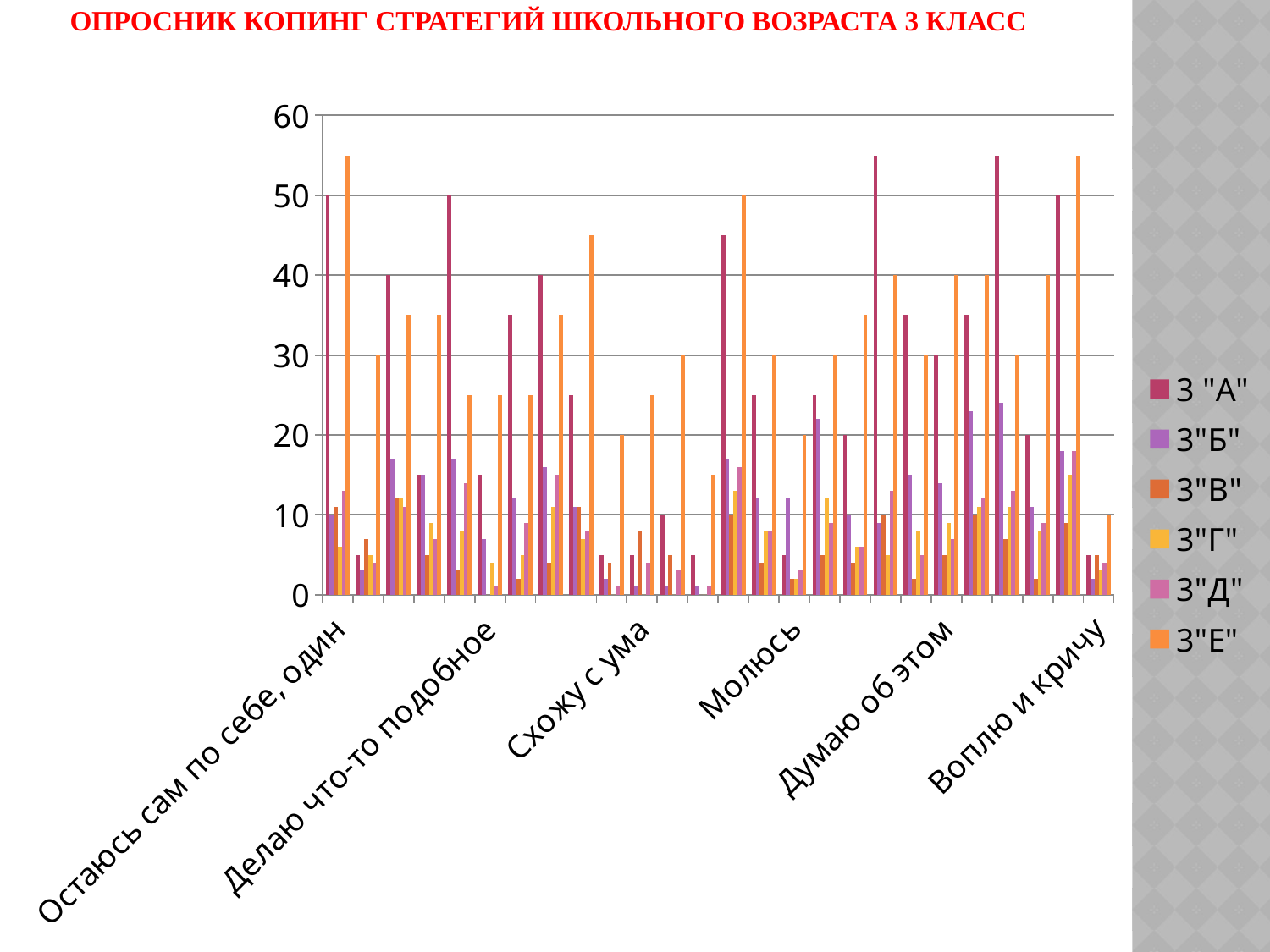
What kind of chart is shown on the slide? bar chart Is the tallest bar on the chart greater or less than 50? greater How many category labels are readable along the x axis? 6 How many series does the legend list? 6 Which series is listed first in the legend? 3 "А" Is the tallest bar on the chart greater or less than 60? less What is the title of the slide above the chart? ОПРОСНИК КОПИНГ СТРАТЕГИЙ ШКОЛЬНОГО ВОЗРАСТА 3 КЛАСС